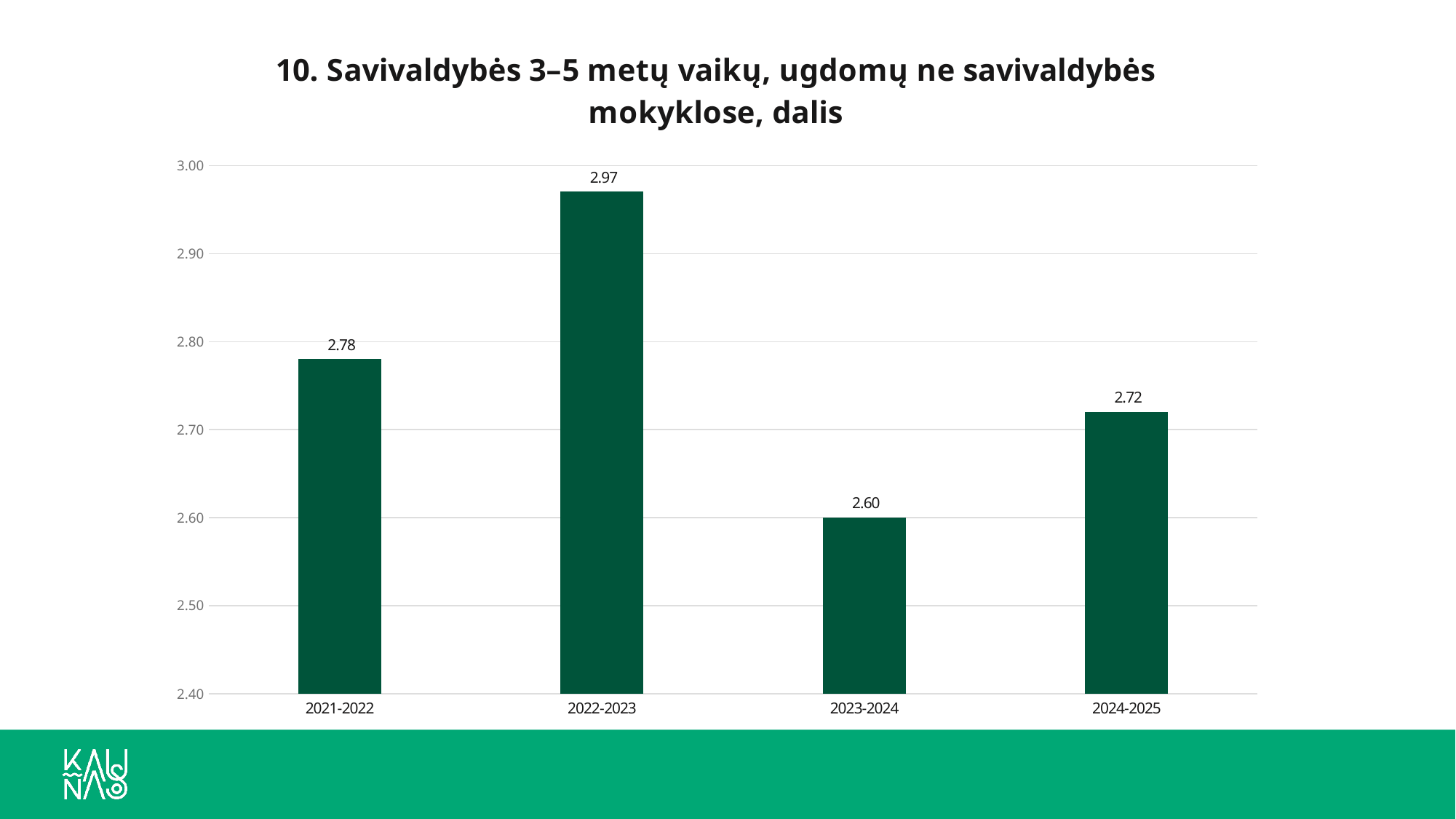
How many school years are shown on the x axis? 4 What is the value for 2021-2022? 2.78 Which school year has the highest value? 2022-2023 What is the title of the chart? 10. Savivaldybės 3–5 metų vaikų, ugdomų ne savivaldybės mokyklose, dalis What is the value for 2022-2023? 2.97 Is the value for 2024-2025 greater or less than 2.80? less What kind of chart is shown on the slide? bar chart Which is larger, the value for 2021-2022 or the value for 2024-2025? 2021-2022 What is the value for 2023-2024? 2.60 What is the difference between the values for 2022-2023 and 2023-2024? 0.37 Which school year has the lowest value? 2023-2024 What is the value for 2024-2025? 2.72